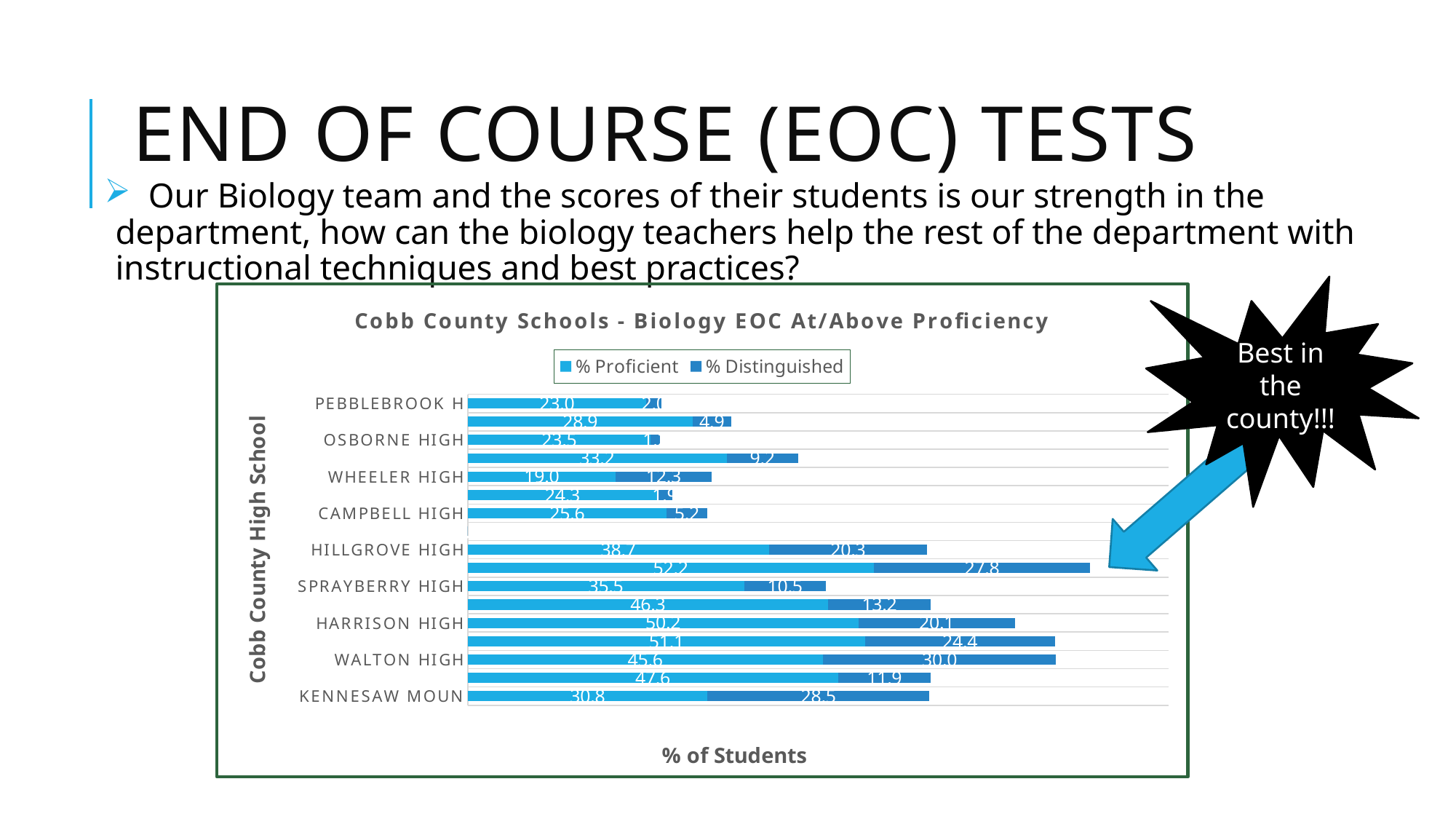
What is the title of the chart? Cobb County Schools - Biology EOC At/Above Proficiency What is the total of the stacked bar for Walton High? 75.6 Which school has the lowest % Proficient value? Wheeler High What is the % Proficient value for Wheeler High? 19.0 What is the difference between the % Proficient values for Harrison High and Campbell High? 24.6 What type of chart is shown on the slide? Bar chart What is the x-axis title of the chart? % of Students What is the % Distinguished value for Kennesaw Mountain? 28.5 Which has a higher % Distinguished value, Hillgrove High or Sprayberry High? Hillgrove High How many series does the legend list? 2 What is the % Distinguished value for Walton High? 30.0 What is the % Proficient value for Harrison High? 50.2